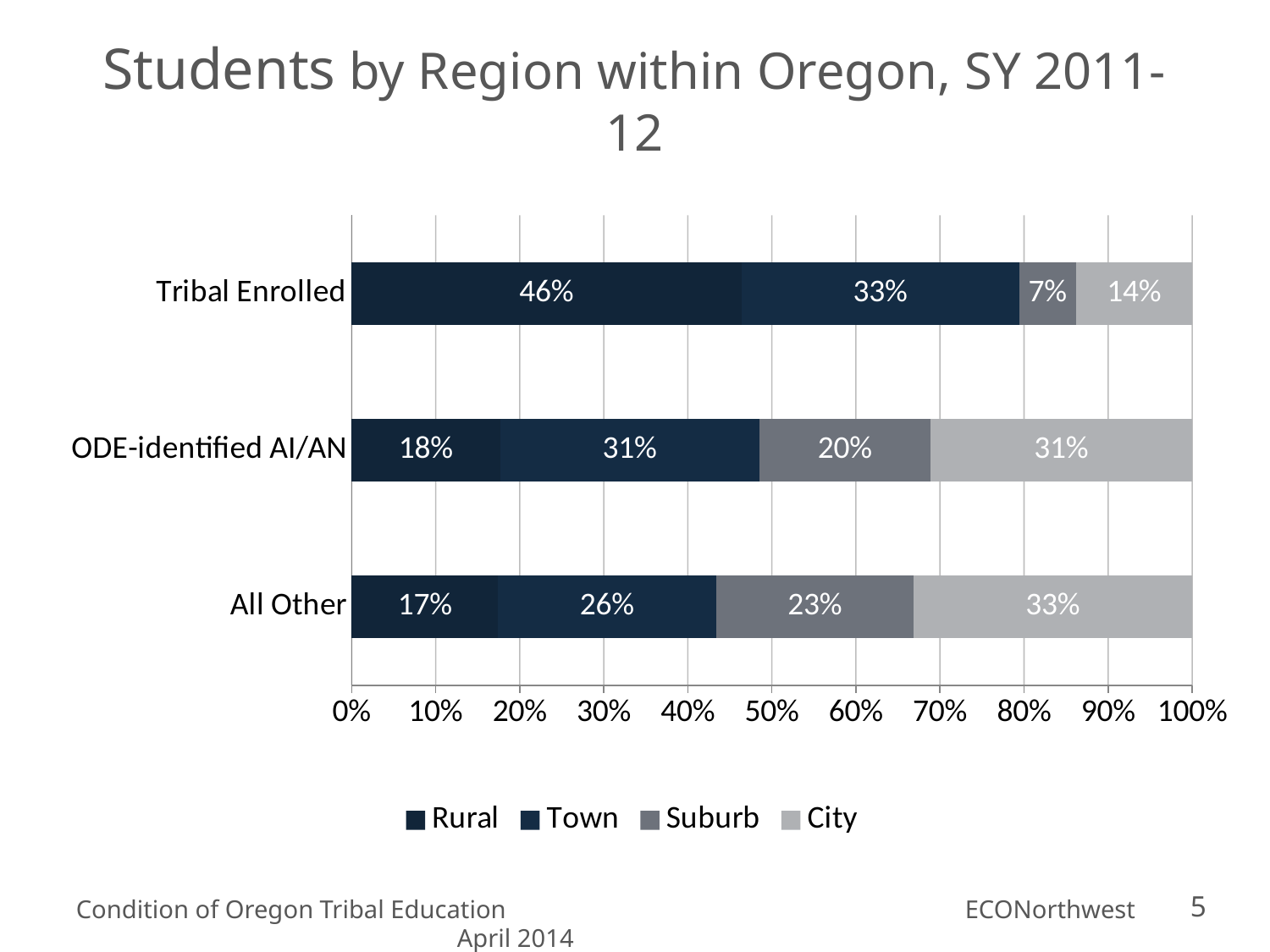
How many categories are shown on the y axis? 3 How many series does the legend list? 4 What is the Town share for Tribal Enrolled students? 33% What is the Suburb share for All Other students? 23% Which is larger: the Town share for ODE-identified AI/AN or the Town share for All Other? ODE-identified AI/AN What is the City share for ODE-identified AI/AN students? 31% What is the title of the chart? Students by Region within Oregon, SY 2011-12 What is the Rural share for Tribal Enrolled students? 46% Which category has the lowest Suburb share? Tribal Enrolled What is the difference between the City share for All Other and the City share for Tribal Enrolled? 19% Which category has the highest Rural share? Tribal Enrolled What kind of chart is shown on the slide? Stacked bar chart